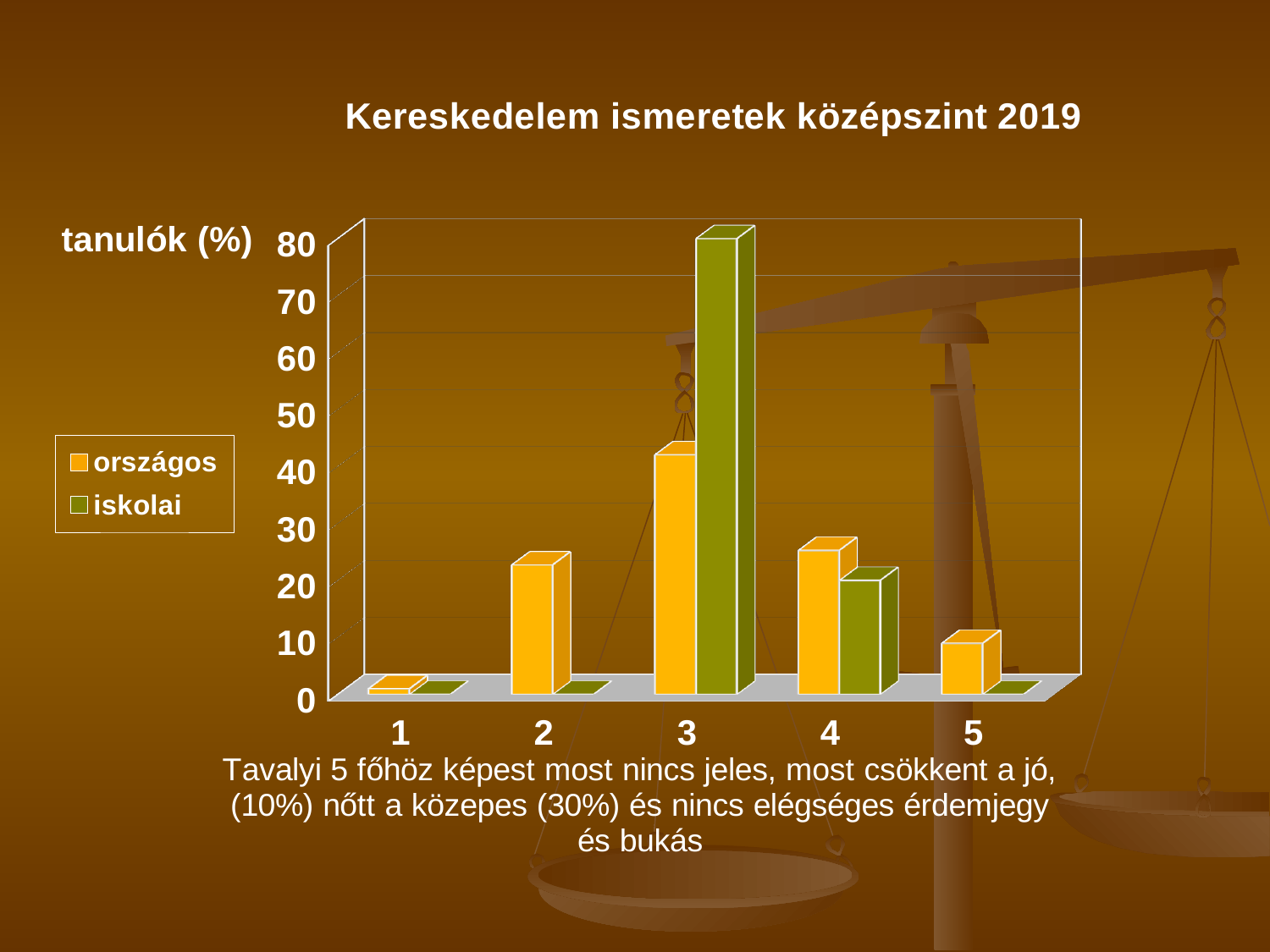
What kind of chart is shown on the slide? bar chart How many series does the legend list? 2 For which category is the iskolai value highest? 3 How many categories are shown on the x axis? 5 For category 3, which series has the larger value, országos or iskolai? iskolai Which two series are listed in the legend? országos, iskolai Is the iskolai value for category 3 greater or less than 70? greater For which category is the országos value lowest? 1 Is the országos value for category 5 greater or less than 20? less What is the title of the chart? Kereskedelem ismeretek középszint 2019 For which category is the országos value highest? 3 Is the iskolai value for category 4 greater or less than 30? less